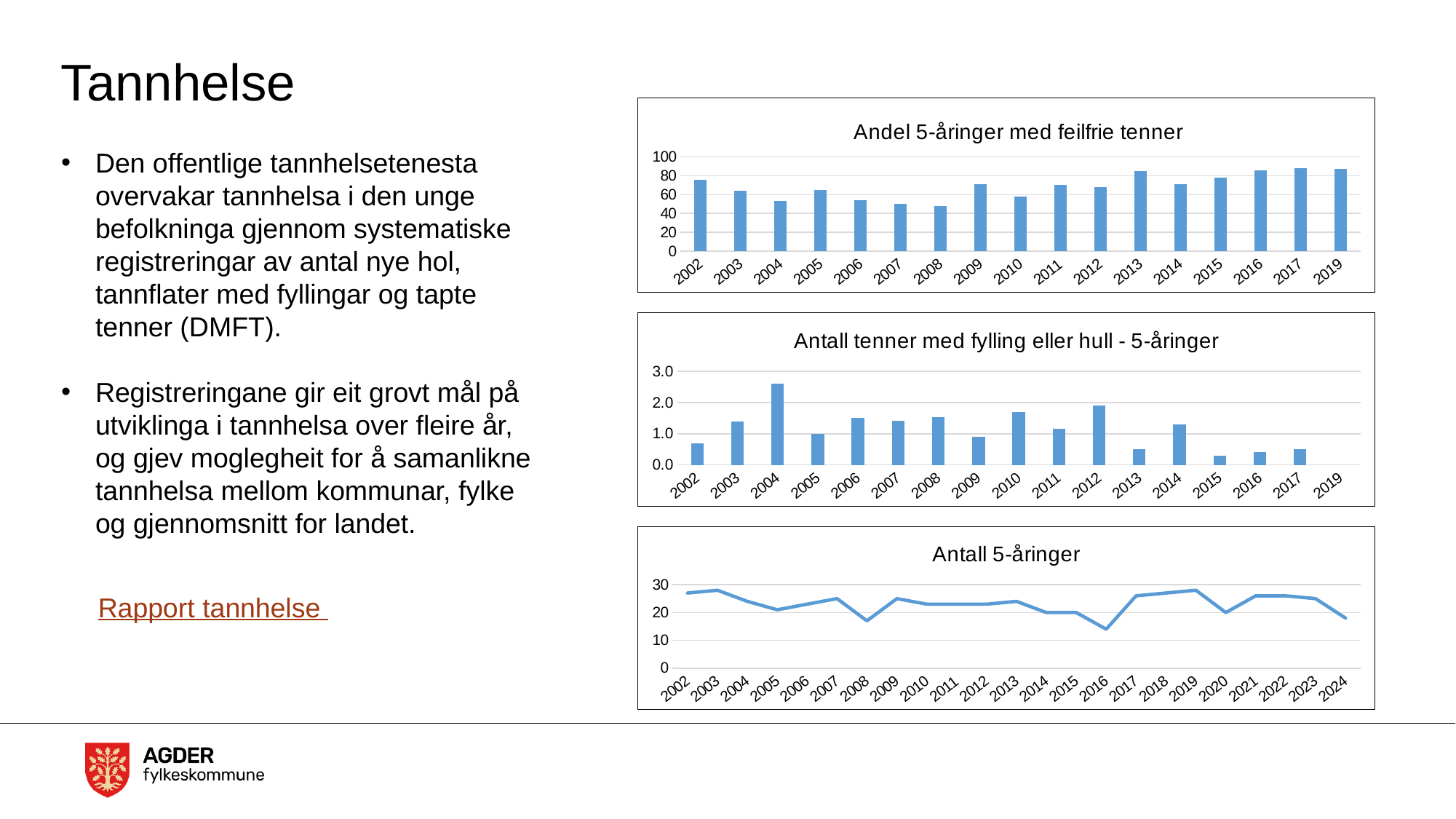
In the chart 'Antall 5-åringer', which year has the lowest value? 2016 What type of chart is 'Andel 5-åringer med feilfrie tenner'? bar chart In the chart 'Antall tenner med fylling eller hull - 5-åringer', which is larger, the value for 2004 or the value for 2005? 2004 In the chart 'Antall 5-åringer', is the value for 2019 greater or less than 20? greater How many years are shown on the x axis of the chart 'Antall 5-åringer'? 23 In the chart 'Antall tenner med fylling eller hull - 5-åringer', is the value for 2004 greater or less than 2.0? greater In the chart 'Antall tenner med fylling eller hull - 5-åringer', which year has the highest value? 2004 What type of chart is 'Antall 5-åringer'? line chart In the chart 'Andel 5-åringer med feilfrie tenner', is the value for 2002 greater or less than 60? greater In the chart 'Andel 5-åringer med feilfrie tenner', which is larger, the value for 2013 or the value for 2008? 2013